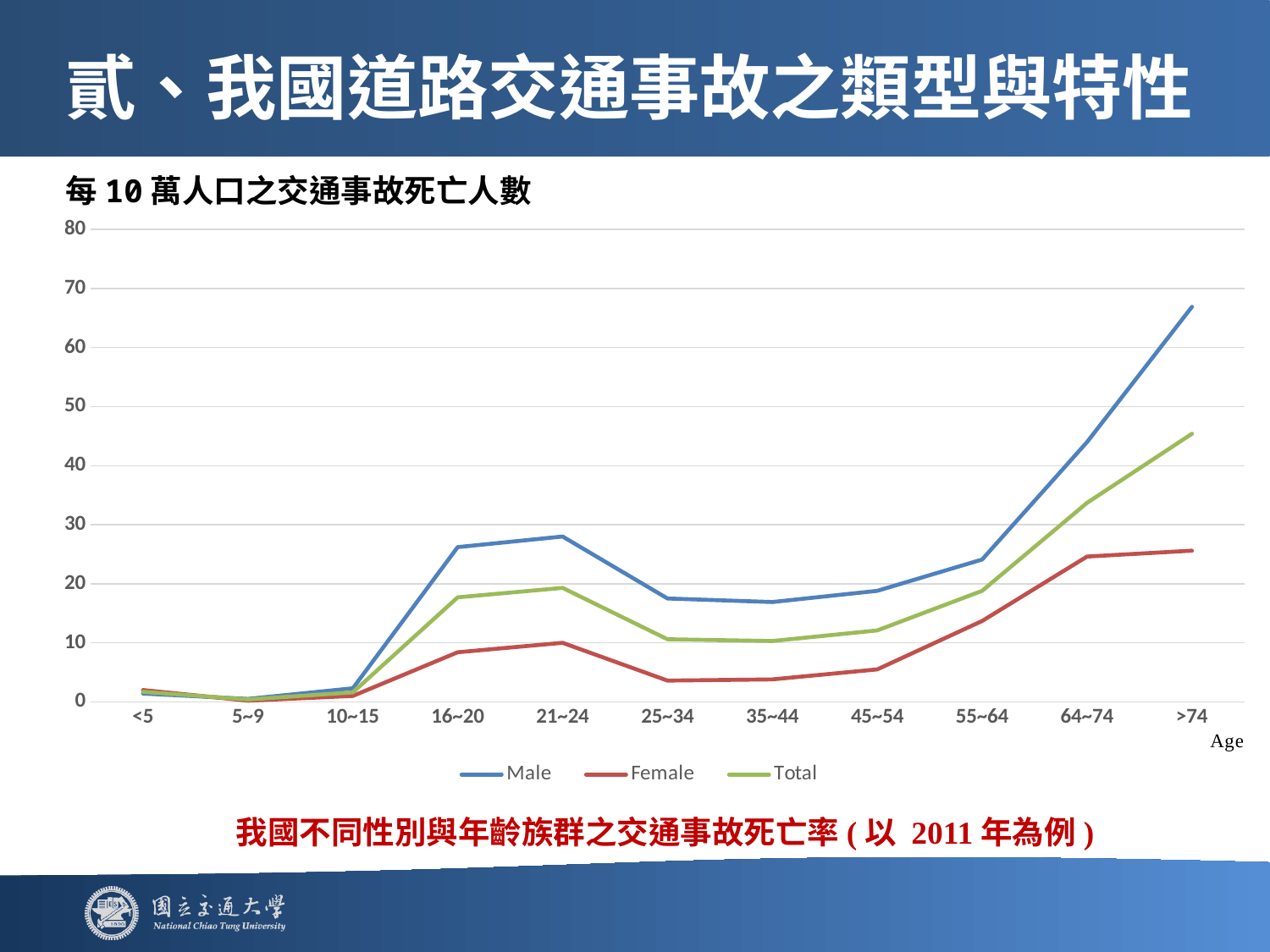
For the 21~24 age group, which is larger, the Male value or the Female value? Male Is the Female value for the >74 age group greater or less than 30? less Is the Male value for the 21~24 age group greater or less than 20? greater How many age groups are shown on the x axis? 11 What kind of chart is shown on the slide? line chart How many series does the legend list? 3 Is the Male value for the >74 age group greater or less than 60? greater Which age group has the highest value for the Male series? >74 Does the Male series rise or fall from the 55~64 age group to the >74 age group? rise What are the three series listed in the legend? Male, Female, Total Which age group has the highest value for the Female series? >74